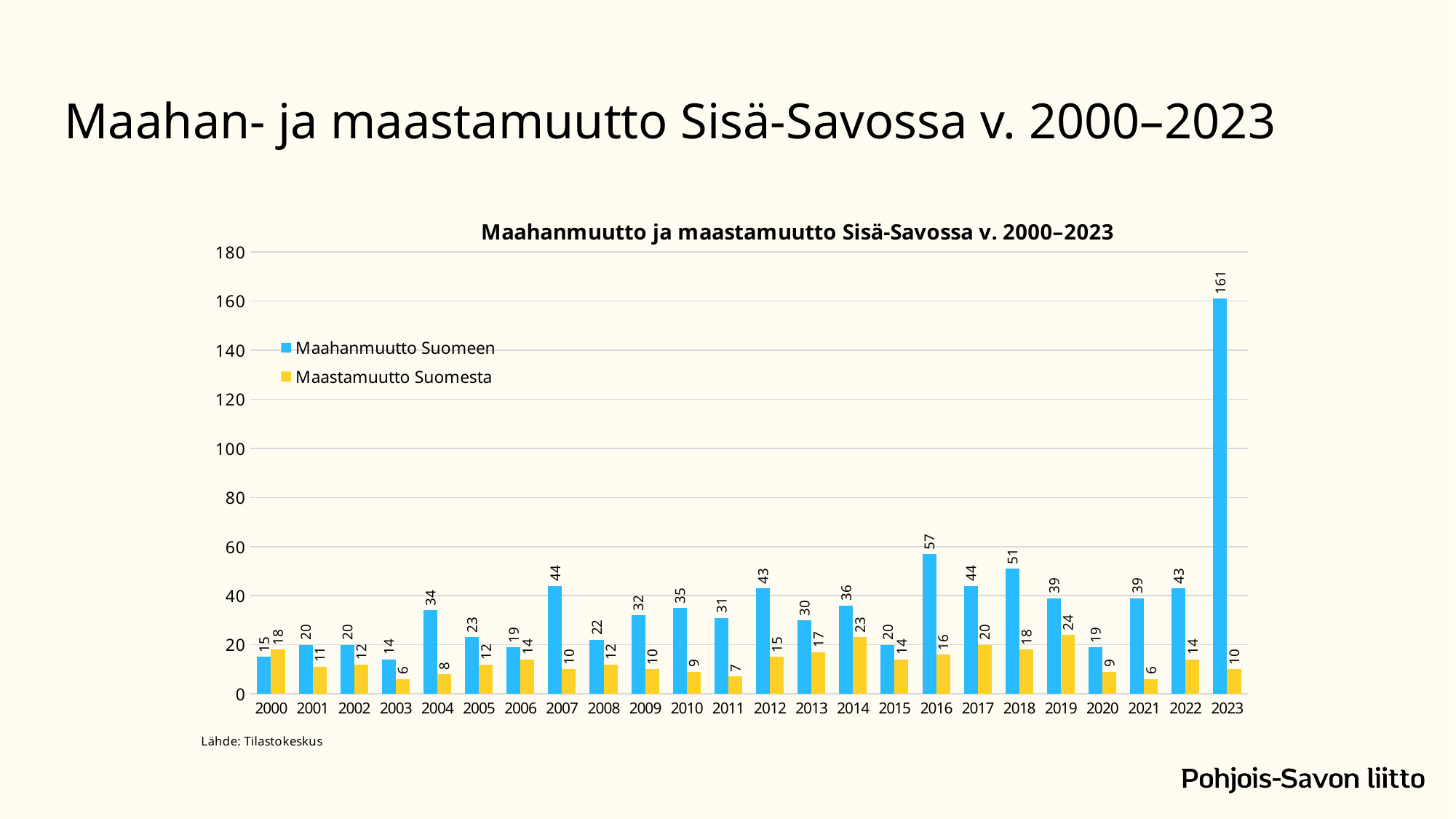
Which year has the highest value for Maastamuutto Suomesta? 2019 How many years are shown on the x axis? 24 Which year has the highest value for Maahanmuutto Suomeen? 2023 Is the value for Maahanmuutto Suomeen in 2023 greater or less than 140? greater What is the value of Maahanmuutto Suomeen in 2023? 161 How many series does the legend list? 2 What kind of chart is shown on the slide? Bar chart In 2000, which is larger: Maahanmuutto Suomeen or Maastamuutto Suomesta? Maastamuutto Suomesta Which year has the lowest value for Maahanmuutto Suomeen? 2003 What is the difference between Maahanmuutto Suomeen and Maastamuutto Suomesta in 2018? 33 What is the value of Maastamuutto Suomesta in 2014? 23 What is the value of Maahanmuutto Suomeen in 2016? 57